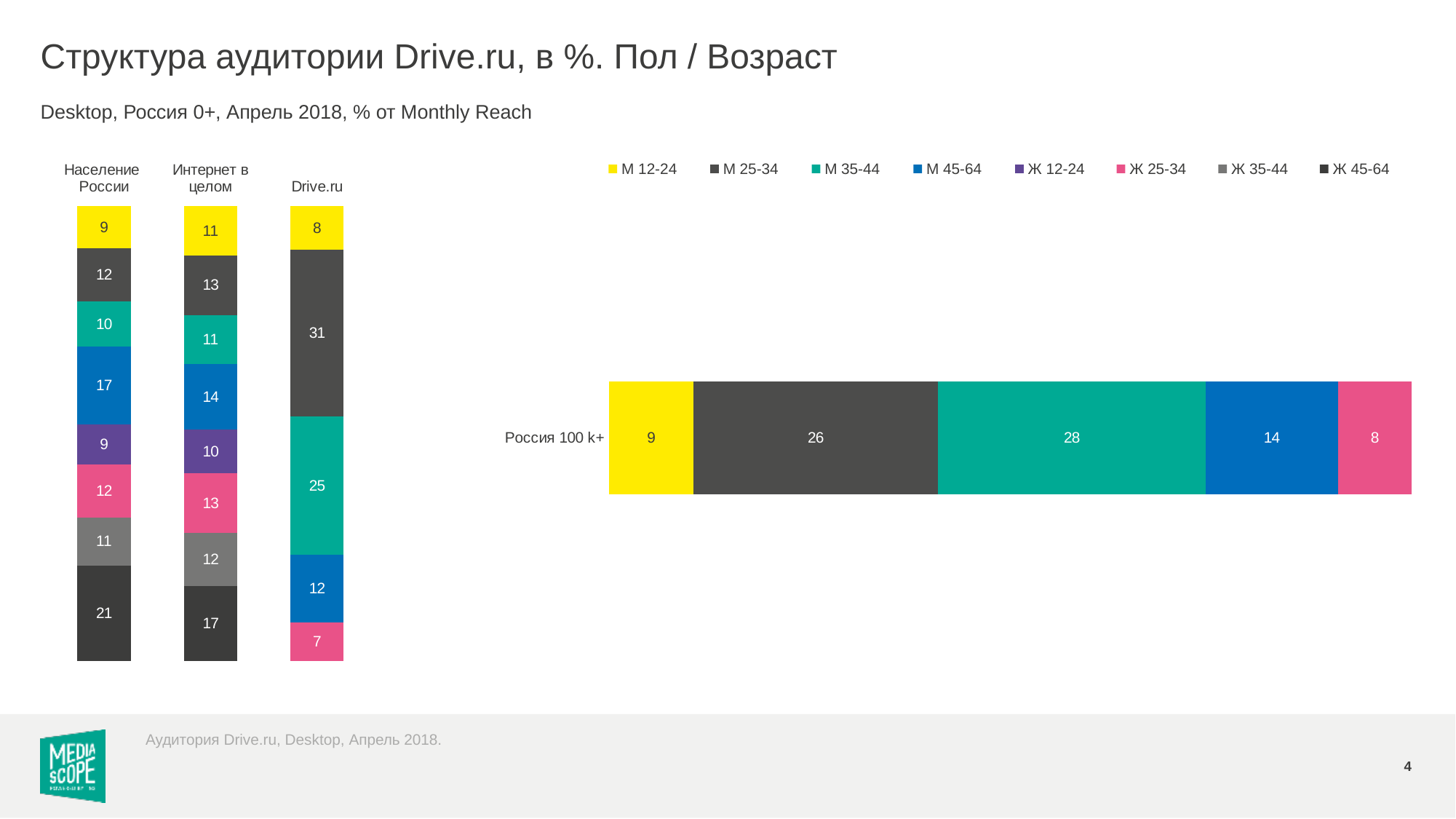
In the left chart, which segment of the Drive.ru bar is the largest? М 25-34 In the left chart, what is the value of the М 45-64 segment for Интернет в целом? 14 In the left chart, what is the value of the М 25-34 segment for Drive.ru? 31 In the left chart, how many bars (audience groups) are shown? 3 In the right chart, which is larger for Россия 100 k+: the М 25-34 segment or the М 35-44 segment? М 35-44 In the left chart, what is the value of the Ж 45-64 segment for Население России? 21 In the left chart, what is the difference between the М 25-34 values for Drive.ru and Интернет в целом? 18 What type of chart is the right chart? Stacked bar chart In the right chart, what is the value of the М 35-44 segment for Россия 100 k+? 28 In the right chart, what is the total of the Россия 100 k+ bar? 85 How many series does the legend list? 8 In the left chart, which segment of the Drive.ru bar is the smallest? Ж 25-34